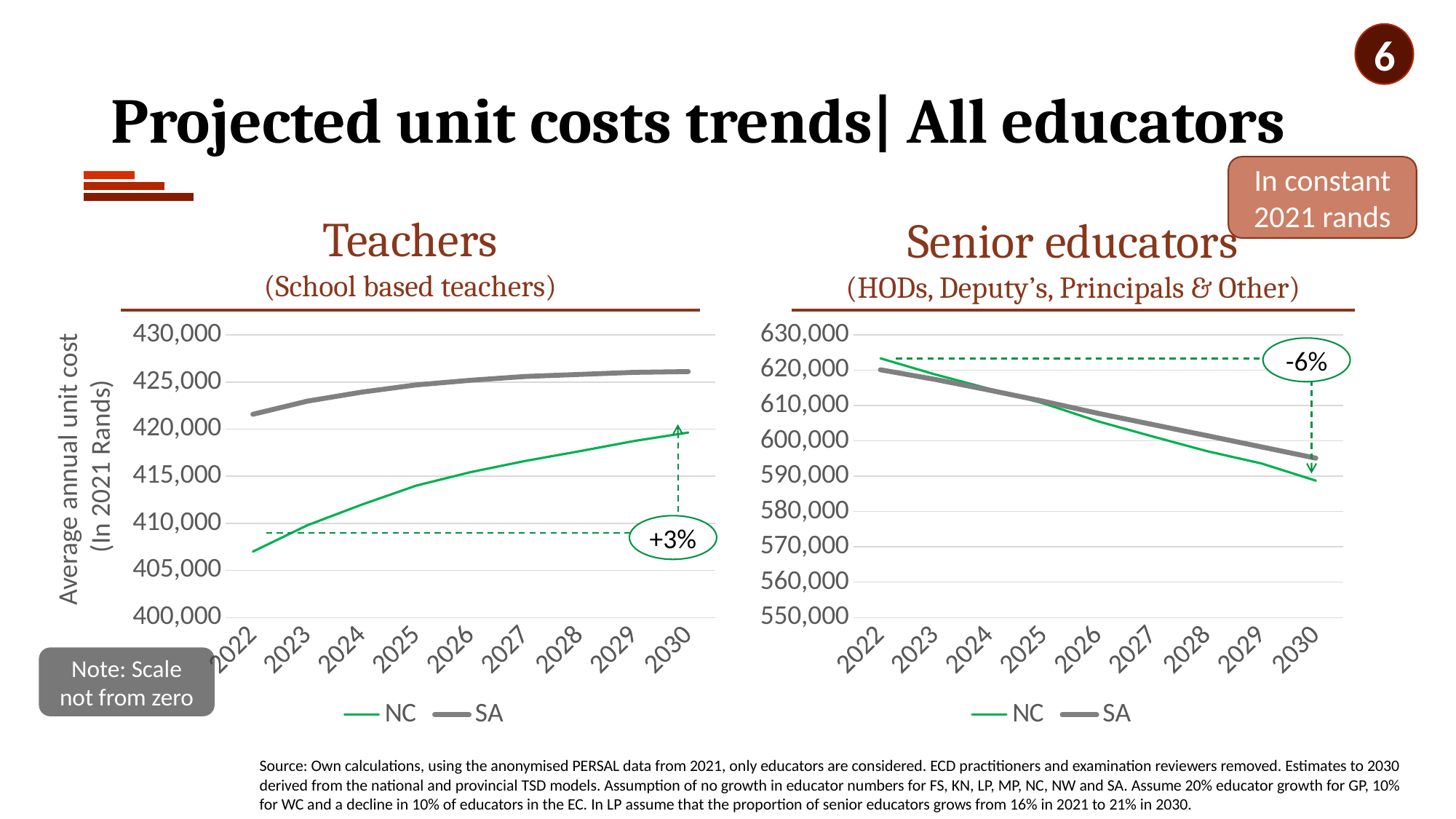
What percentage change is annotated on the Senior educators chart? -6% In the Teachers chart, is the SA value for 2030 greater or less than 425,000? greater In the Senior educators chart, which series has the higher value in 2030, NC or SA? SA How many series does the legend of the Senior educators chart list? 2 In the Teachers chart, does the NC line rise or fall from 2022 to 2030? rise In the Senior educators chart, is the NC value for 2022 greater or less than 620,000? greater In the Teachers chart, is the NC value for 2022 greater or less than 410,000? less How many years are plotted along the x axis of the Teachers chart? 9 What kind of chart is the Teachers chart? line chart In the Senior educators chart, does the SA line rise or fall from 2022 to 2030? fall In the Teachers chart, which series has the higher value in 2022, NC or SA? SA